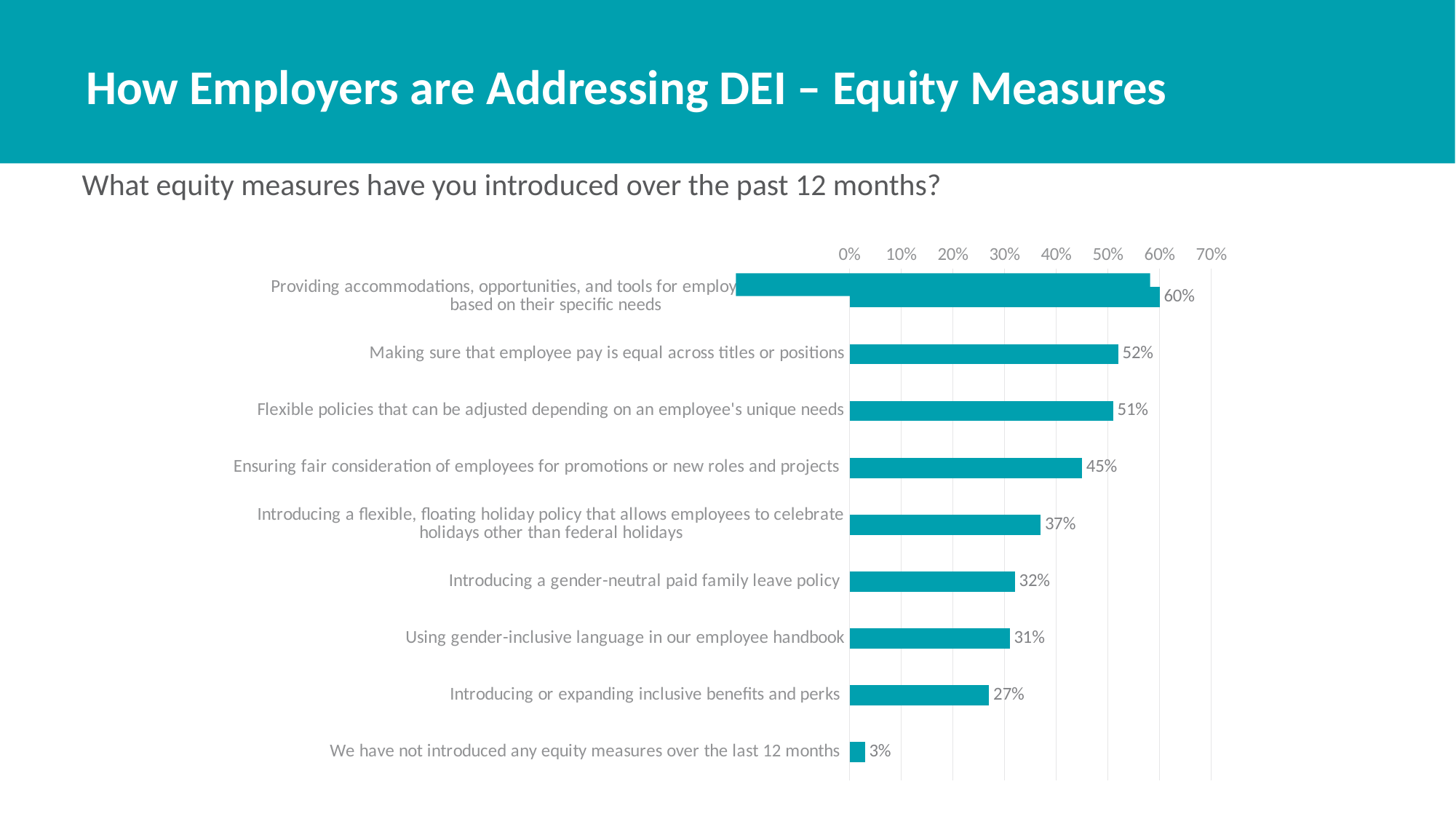
What is the difference between 'Ensuring fair consideration of employees for promotions or new roles and projects' and 'Introducing or expanding inclusive benefits and perks'? 18% What type of chart is used on this slide? Bar chart What value is shown for 'Flexible policies that can be adjusted depending on an employee's unique needs'? 51% What value is shown for 'We have not introduced any equity measures over the last 12 months'? 3% What is the value of the topmost bar in the chart? 60% What percentage of employers said they are making sure that employee pay is equal across titles or positions? 52% Which equity measure has the lowest percentage in the chart? We have not introduced any equity measures over the last 12 months How many equity measures (categories) are shown in the chart? 9 What percentage is shown for 'Introducing a gender-neutral paid family leave policy'? 32% Which is larger: 'Introducing a flexible, floating holiday policy that allows employees to celebrate holidays other than federal holidays' or 'Using gender-inclusive language in our employee handbook'? Introducing a flexible, floating holiday policy that allows employees to celebrate holidays other than federal holidays Is the value for 'Introducing or expanding inclusive benefits and perks' greater or less than 30%? less What is the highest value shown on the percentage axis of the chart? 70%